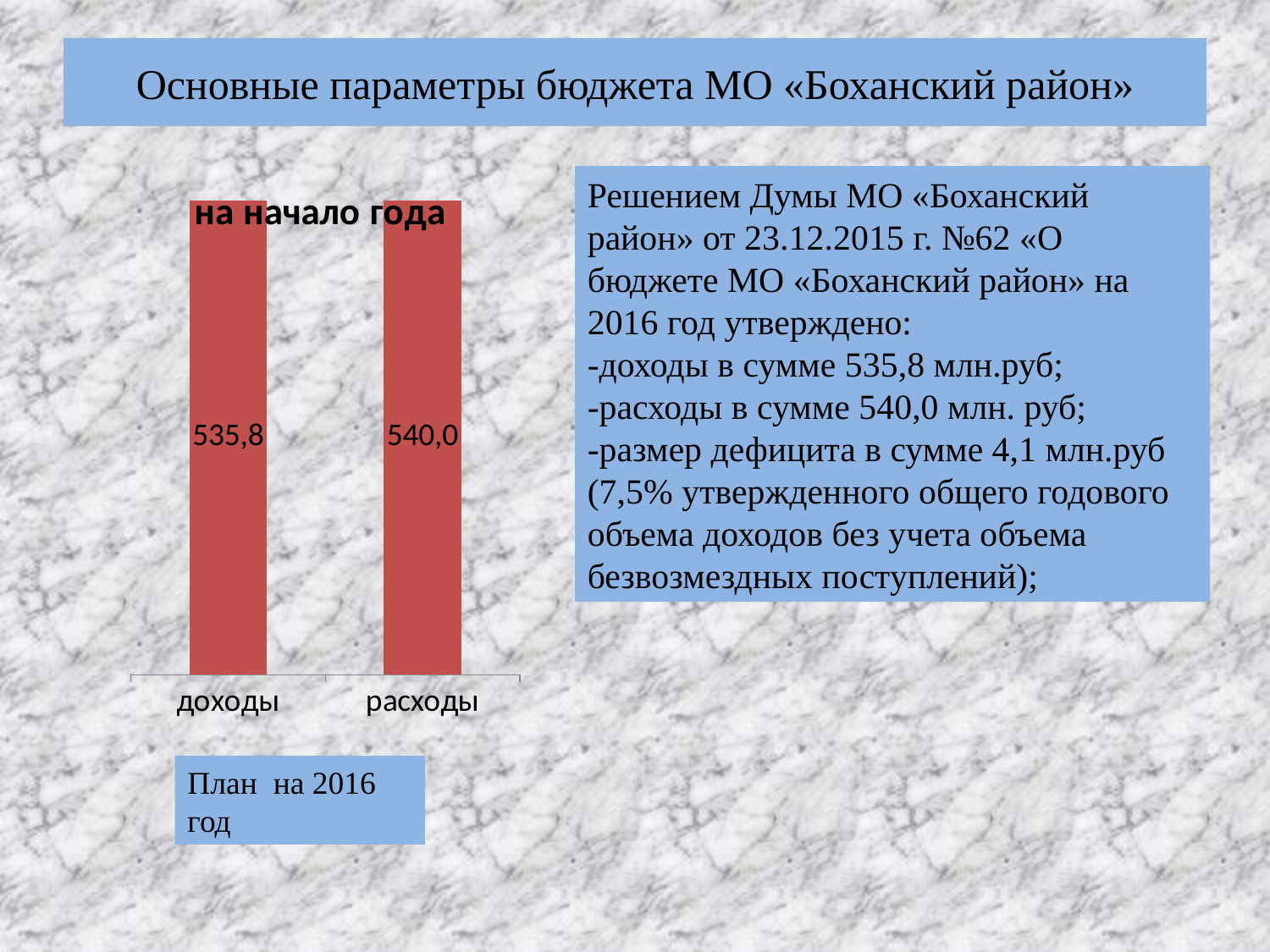
What is the difference between the values for расходы and доходы? 4,2 What is the title of the chart? на начало года Which category has the higher value, доходы or расходы? расходы What is the value for расходы in the chart? 540,0 How many categories are shown in the chart? 2 Which category has the lowest value in the chart? доходы What kind of chart is shown on the slide? bar chart What is the value for доходы in the chart? 535,8 Which category has the highest value in the chart? расходы What colour are the bars in the chart? red